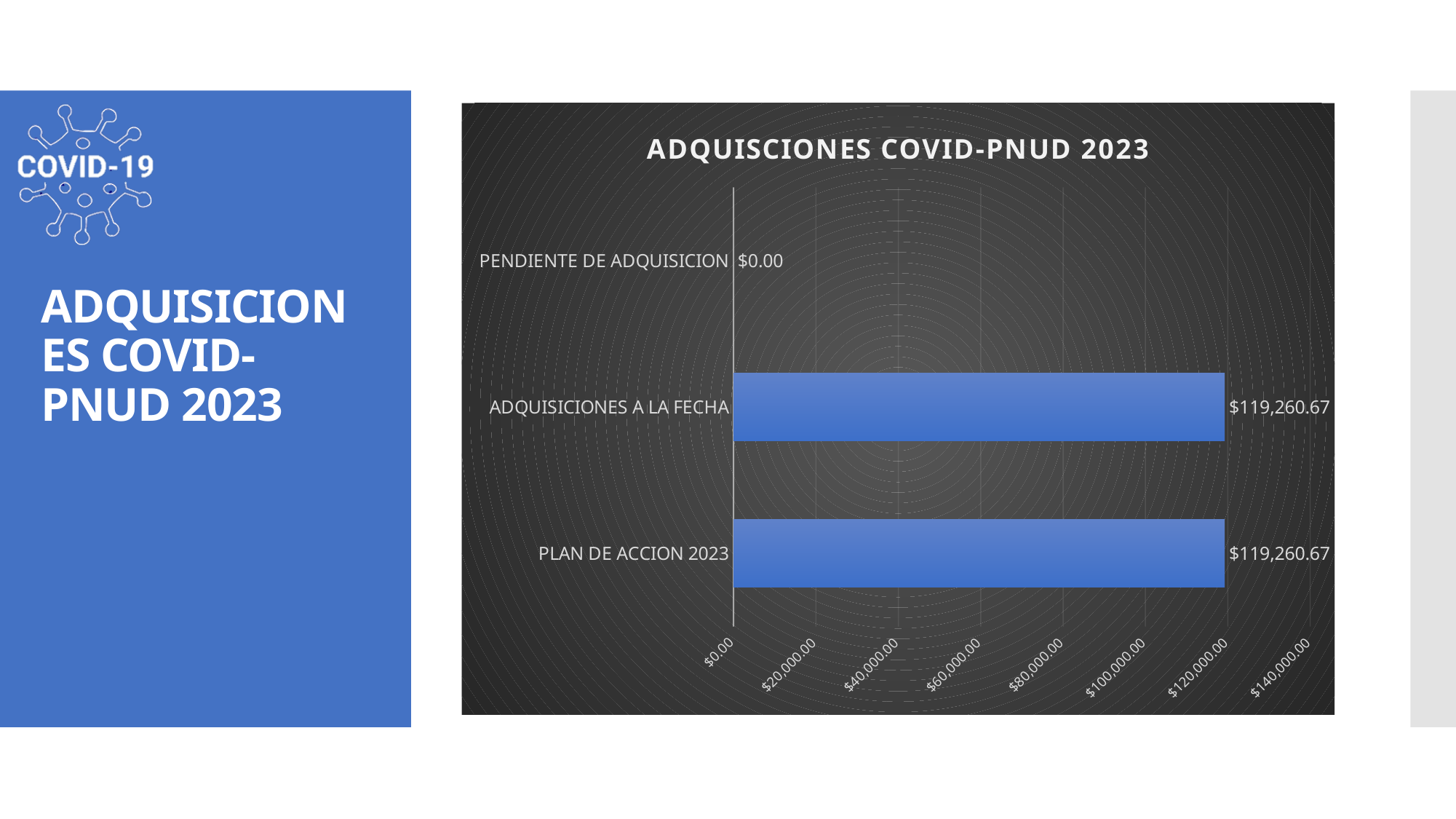
Is the value for ADQUISICIONES A LA FECHA greater or less than $140,000.00? less What is the value for ADQUISICIONES A LA FECHA? $119,260.67 Which category has the lowest value? PENDIENTE DE ADQUISICION What is the value for PLAN DE ACCION 2023? $119,260.67 Is the value for PLAN DE ACCION 2023 greater or less than $100,000.00? greater What is the difference between the values for PLAN DE ACCION 2023 and ADQUISICIONES A LA FECHA? $0.00 What kind of chart is shown on the slide? Bar chart What is the difference between the values for ADQUISICIONES A LA FECHA and PENDIENTE DE ADQUISICION? $119,260.67 Which is larger, the value for ADQUISICIONES A LA FECHA or the value for PENDIENTE DE ADQUISICION? ADQUISICIONES A LA FECHA What is the value for PENDIENTE DE ADQUISICION? $0.00 How many categories are shown in the chart? 3 What is the title of the chart? ADQUISCIONES COVID-PNUD 2023